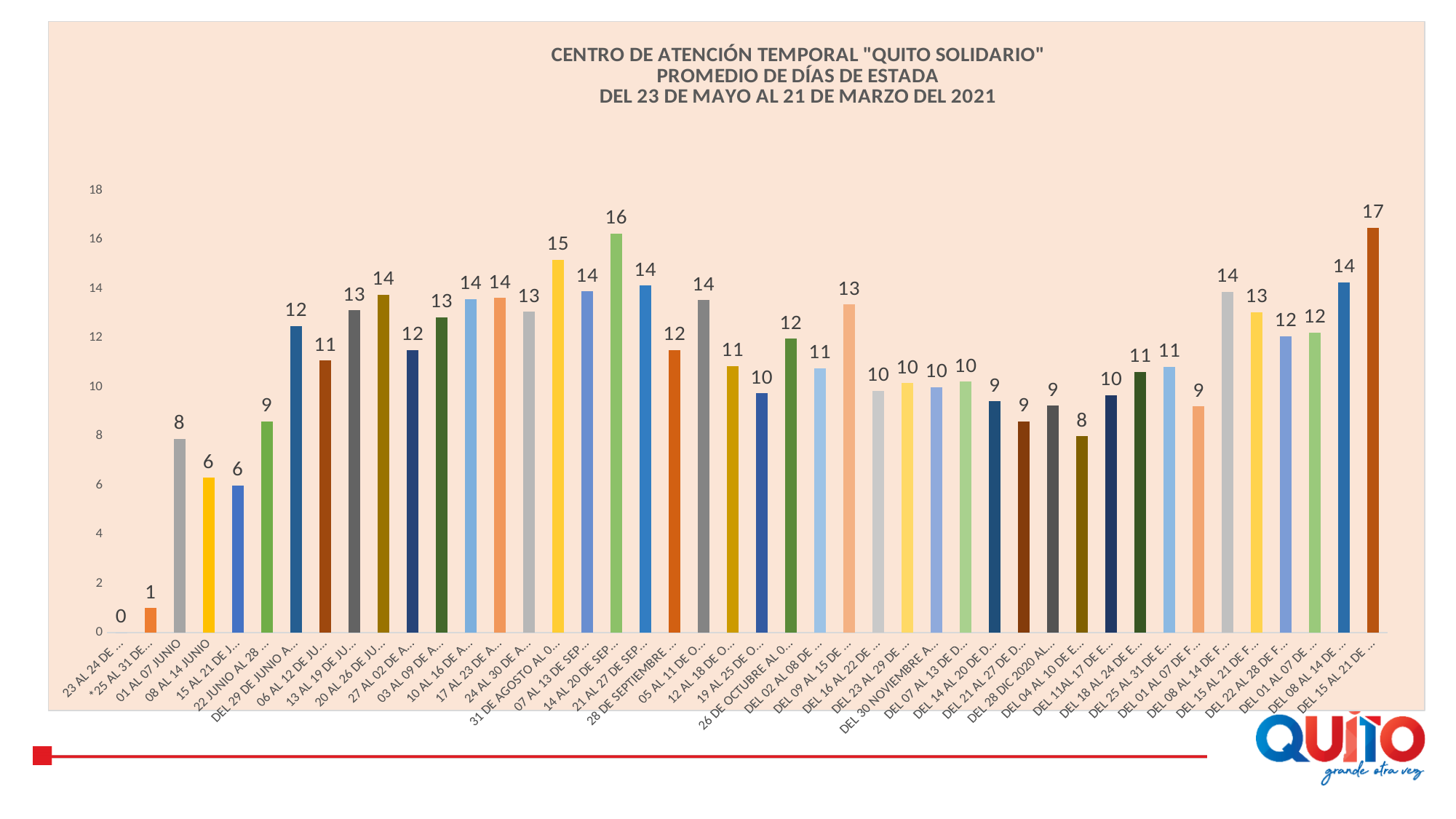
What is the value of the first bar on the left of the chart? 0 What is the value of the last bar on the right of the chart? 17 What is the value for the category beginning "14 AL 20 DE SEP"? 16 What is the highest value shown in the chart? 17 What is the lowest value shown in the chart? 0 What is the value for the category "08 AL 14 JUNIO"? 6 What type of chart is shown on the slide? bar chart Is the value for "01 AL 07 JUNIO" greater or less than 10? less What is the value for the category "01 AL 07 JUNIO"? 8 Which is larger, the value for "01 AL 07 JUNIO" or the value for "08 AL 14 JUNIO"? 01 AL 07 JUNIO What is the difference between the values for "01 AL 07 JUNIO" and "08 AL 14 JUNIO"? 2 What is the first line of the chart title? CENTRO DE ATENCIÓN TEMPORAL "QUITO SOLIDARIO"